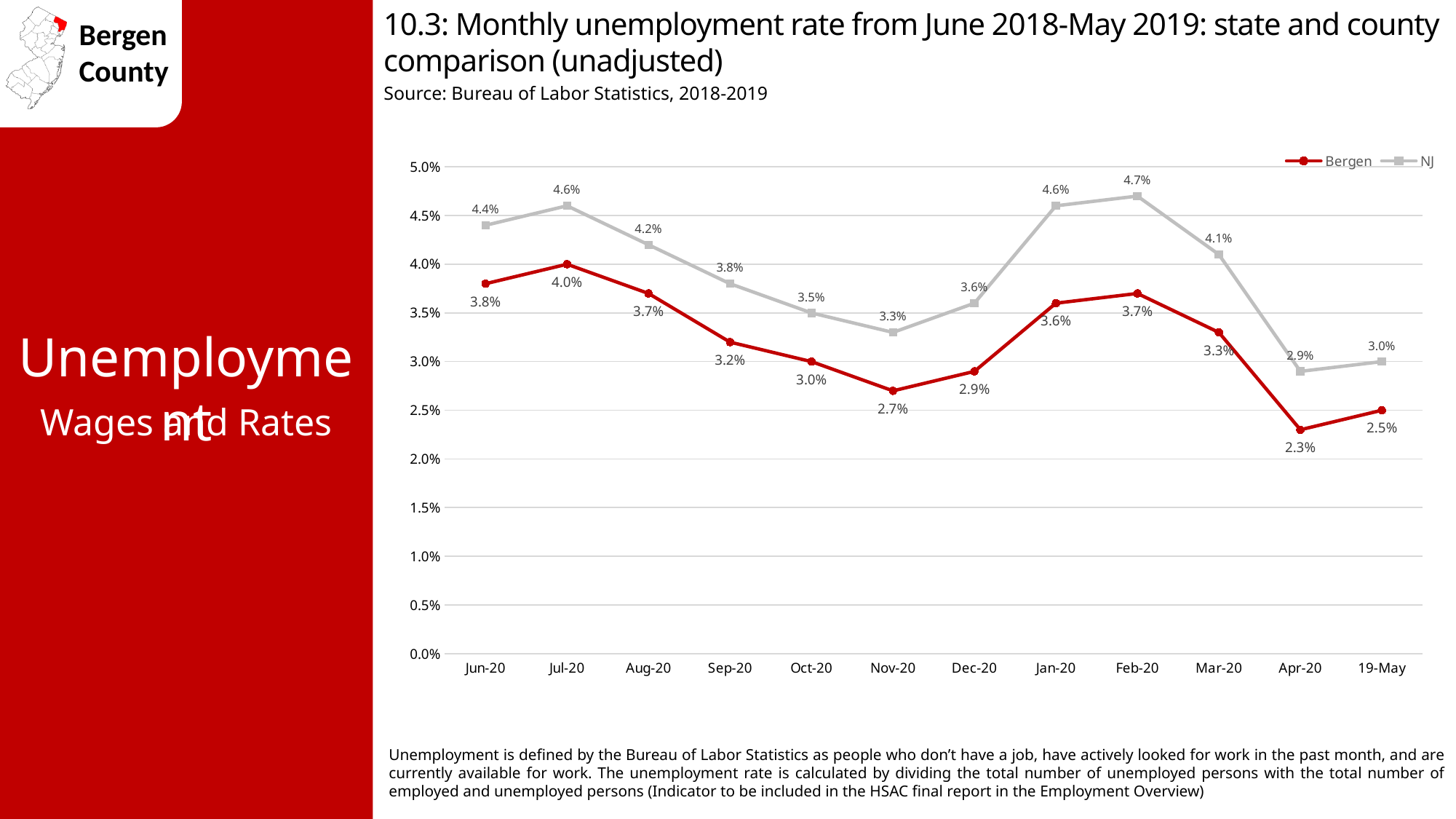
How many months are plotted on the x axis? 12 What is the Bergen unemployment rate for Apr-20? 2.3% How many series does the legend list? 2 What kind of chart is shown on the slide? Line chart In which month is the Bergen unemployment rate lowest? Apr-20 What is the difference between the NJ and Bergen unemployment rates in Jan-20? 1.0% Does the Bergen unemployment rate rise or fall from Jul-20 to Nov-20? Fall Which series has the higher unemployment rate in Mar-20, Bergen or NJ? NJ In which month is the NJ unemployment rate highest? Feb-20 What is the Bergen unemployment rate for Nov-20? 2.7% What is the NJ unemployment rate for Feb-20? 4.7% What is the NJ unemployment rate for Sep-20? 3.8%